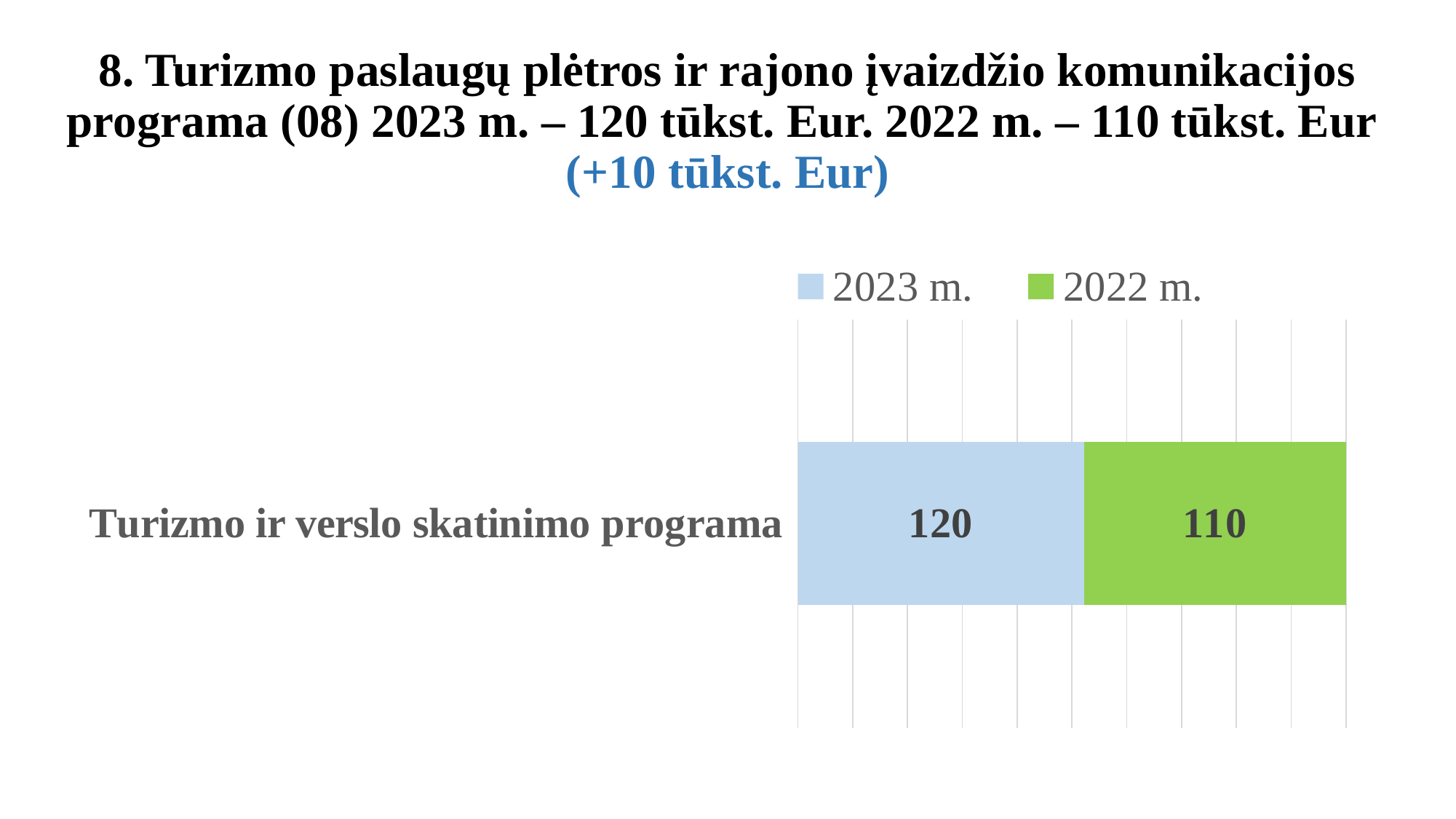
Which series is shown in green in the legend? 2022 m. What is the value for 2023 m. for Turizmo ir verslo skatinimo programa? 120 What is the difference between the 2023 m. and 2022 m. values for Turizmo ir verslo skatinimo programa? 10 How many series does the legend list? 2 Which series has the higher value for Turizmo ir verslo skatinimo programa, 2023 m. or 2022 m.? 2023 m. What is the name of the category shown on the chart? Turizmo ir verslo skatinimo programa How many categories are shown on the chart? 1 What kind of chart is shown on the slide? Stacked horizontal bar chart What is the total of the stacked bar for Turizmo ir verslo skatinimo programa? 230 What is the value for 2022 m. for Turizmo ir verslo skatinimo programa? 110